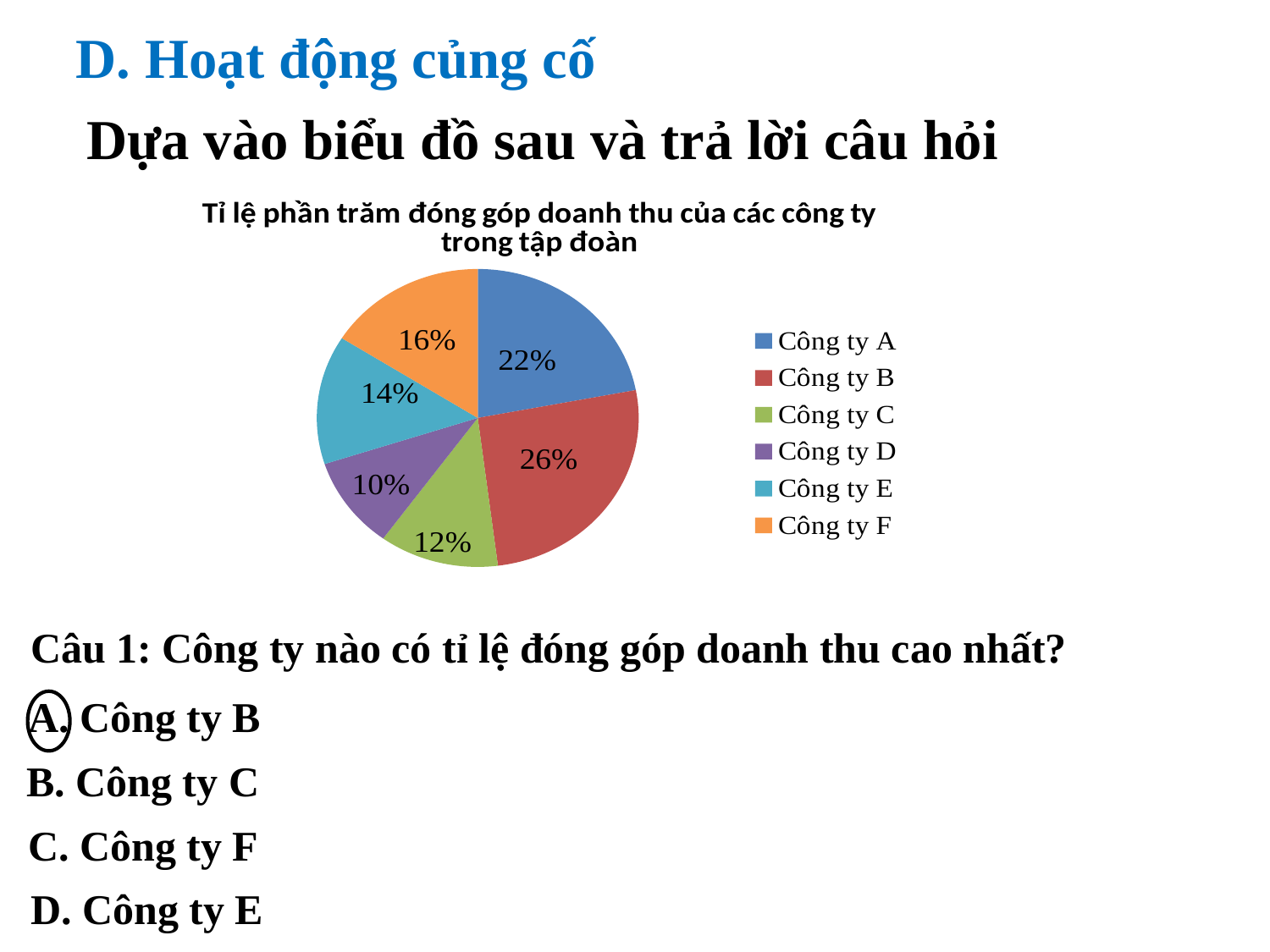
Which company has the largest slice of the pie chart? Công ty B How many companies are shown in the pie chart? 6 What is the difference between the shares of Công ty F and Công ty C? 4% What percentage is labelled for Công ty F? 16% How many entries does the legend list? 6 What is the share shown for Công ty D in the pie chart? 10% What percentage of revenue does Công ty B contribute according to the pie chart? 26% What is the title of the chart? Tỉ lệ phần trăm đóng góp doanh thu của các công ty trong tập đoàn What type of chart is shown on the slide? Pie chart What is the difference in percentage points between Công ty B and Công ty A? 4% Which company has the smallest slice of the pie chart? Công ty D Which has a larger share, Công ty E or Công ty C? Công ty E